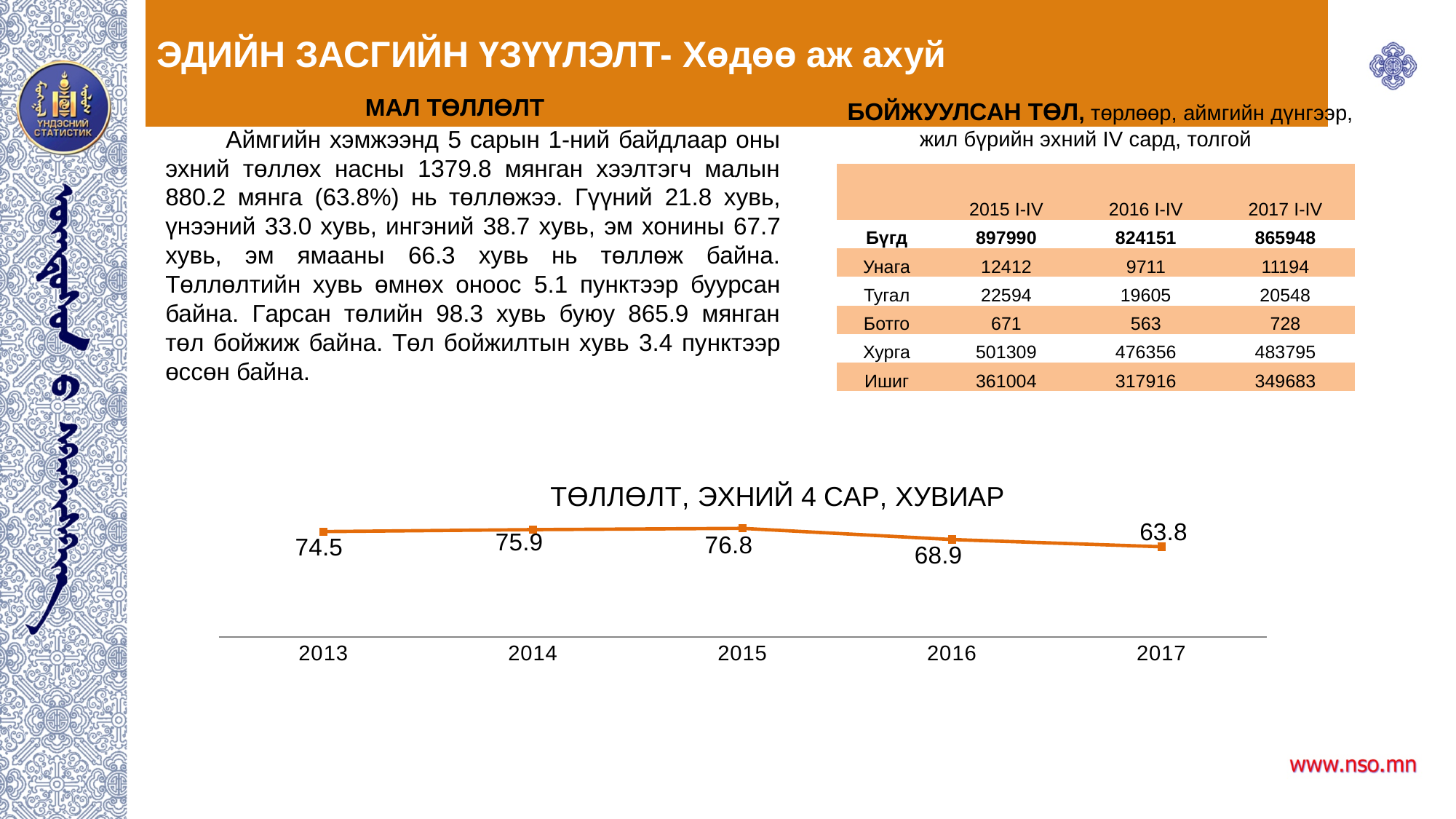
What type of chart is shown on the slide? line chart What is the difference between the values for 2014 and 2013 in the chart? 1.4 What is the value for 2013 in the chart? 74.5 What is the value for 2017 in the chart? 63.8 What is the value for 2016 in the chart? 68.9 What is the value for 2015 in the chart? 76.8 Which year has the lowest value in the chart? 2017 Which is larger in the chart, the value for 2014 or the value for 2016? 2014 Which year has the highest value in the chart? 2015 What is the title of the chart on the slide? ТӨЛЛӨЛТ, ЭХНИЙ 4 САР, ХУВИАР What is the difference between the values for 2015 and 2017 in the chart? 13.0 How many years are plotted on the x axis of the chart? 5